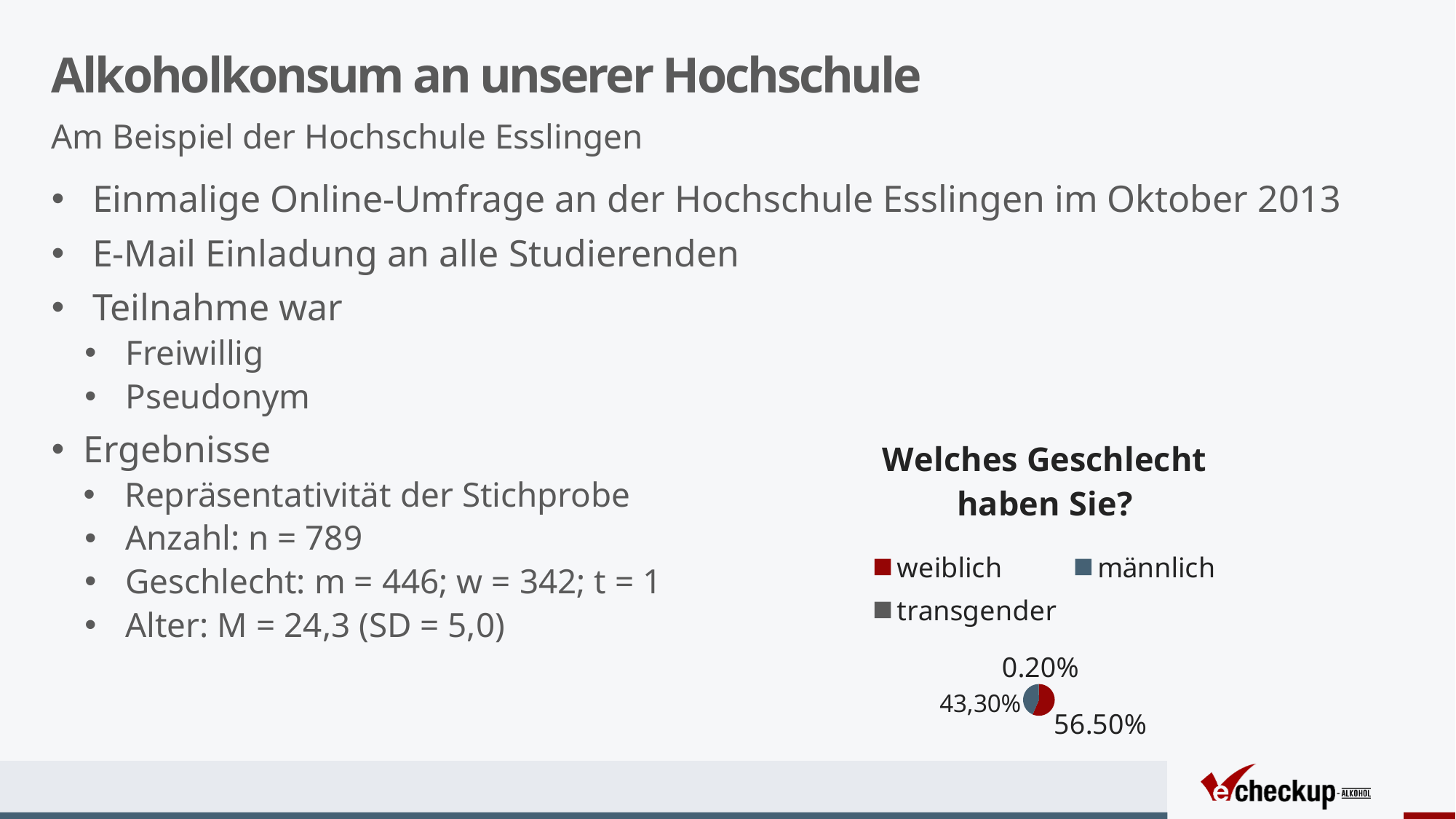
What is the largest percentage label shown on the pie chart? 56.50% What share of the pie does the transgender slice have? 0.20% How many slices does the pie chart have? 3 Which category has the smallest share in the pie chart? transgender How many categories does the legend of the pie chart list? 3 Which colour represents 'weiblich' in the pie chart legend? red What is the title of the pie chart? Welches Geschlecht haben Sie? Is the share for transgender in the pie chart greater or less than 1%? less What is the smallest percentage label shown on the pie chart? 0.20% What kind of chart is shown on the slide? pie chart Which is larger in the pie chart: the 56.50% slice or the 43,30% slice? 56.50%